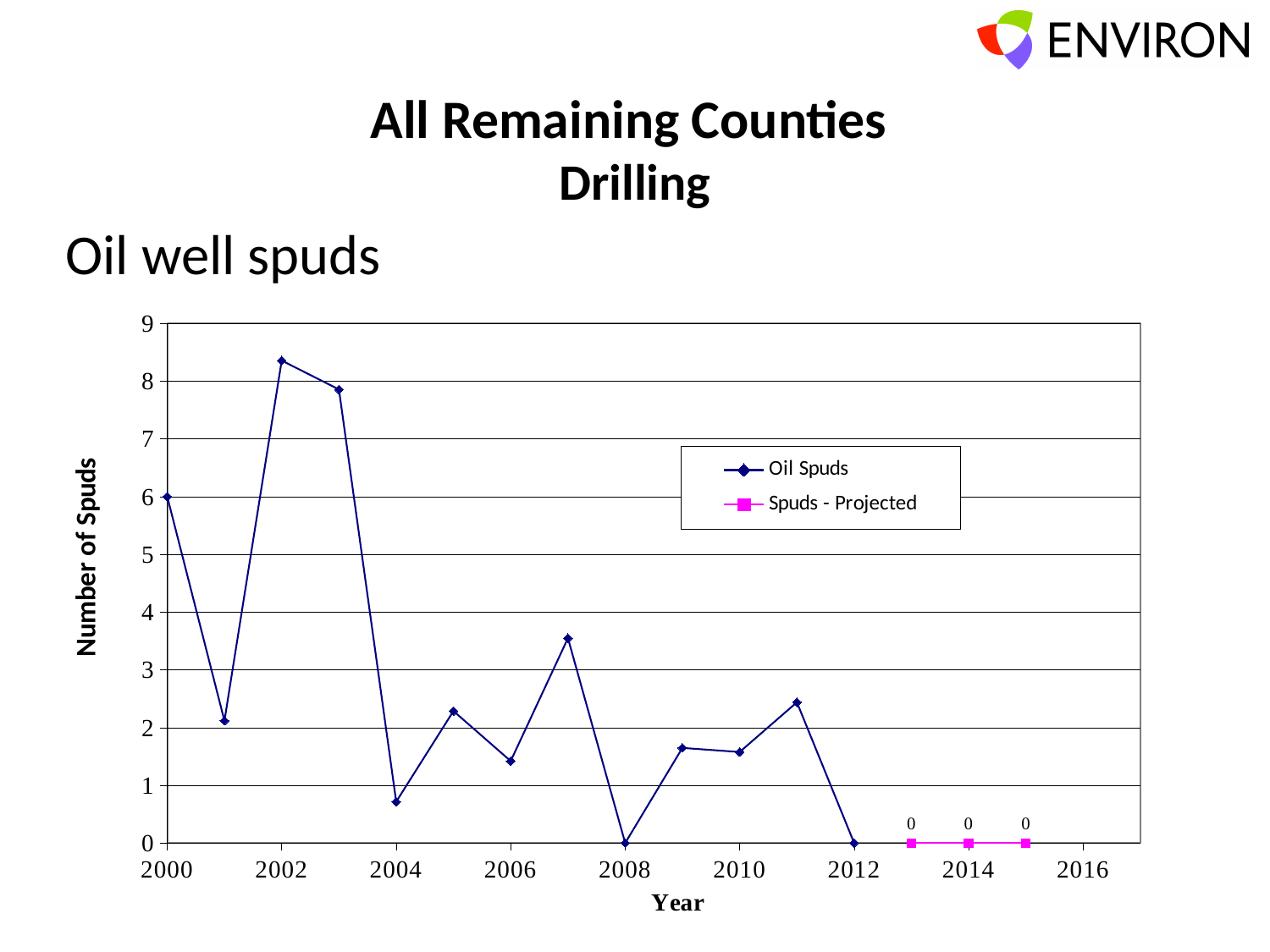
Is the number of oil spuds in 2007 greater or less than 3? greater What is the number of oil spuds in 2012? 0 Is the number of oil spuds in 2004 greater or less than 1? less How many series does the legend list? 2 What is the projected number of spuds for 2014? 0 What is the number of oil spuds in 2008? 0 How many years have a Spuds - Projected data point? 3 In which year is the number of oil spuds highest? 2002 Which year has more oil spuds, 2002 or 2003? 2002 Is the number of oil spuds in 2002 greater or less than 8? greater What are the two series named in the legend? Oil Spuds and Spuds - Projected What kind of chart is shown on the slide? line chart